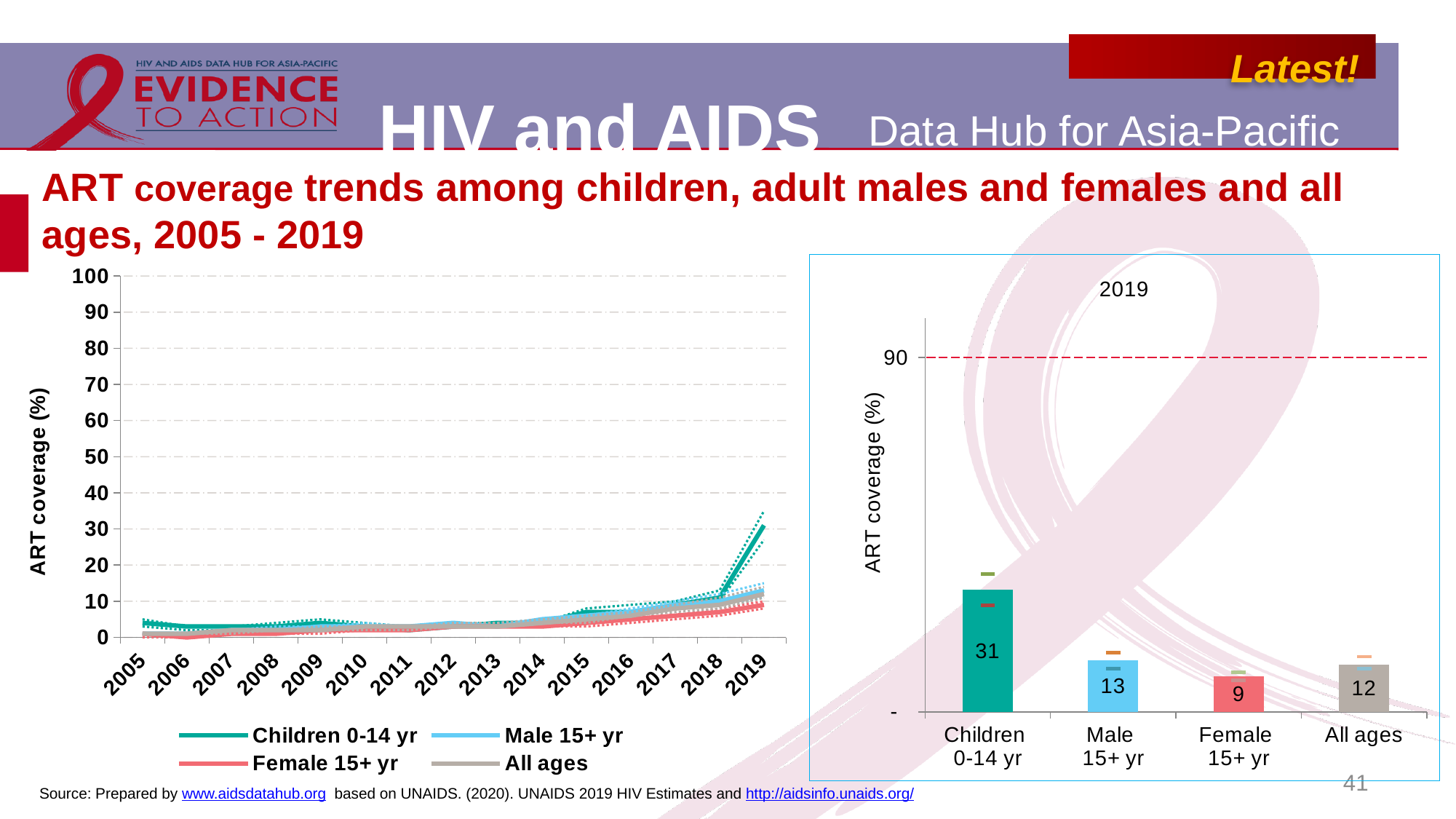
In the 2019 bar chart on the right, which group has the lowest ART coverage? Female 15+ yr In the 2019 bar chart on the right, which group has the highest ART coverage? Children 0-14 yr In the 2019 bar chart on the right, which is larger, the ART coverage for Male 15+ yr or Female 15+ yr? Male 15+ yr What kind of chart is the chart on the right of the slide? bar chart How many years are shown on the x axis of the line chart on the left? 15 In the 2019 bar chart on the right, what value does the red dashed horizontal line mark? 90 How many series does the legend of the line chart on the left list? 4 In the 2019 bar chart on the right, what is the difference between the ART coverage for Children 0-14 yr and Male 15+ yr? 18 In the 2019 bar chart on the right, what is the ART coverage for Children 0-14 yr? 31 In the 2019 bar chart on the right, what is the ART coverage for All ages? 12 In the 2019 bar chart on the right, what is the ART coverage for Female 15+ yr? 9 In the line chart on the left, is the value for Children 0-14 yr in 2019 greater or less than 20? greater